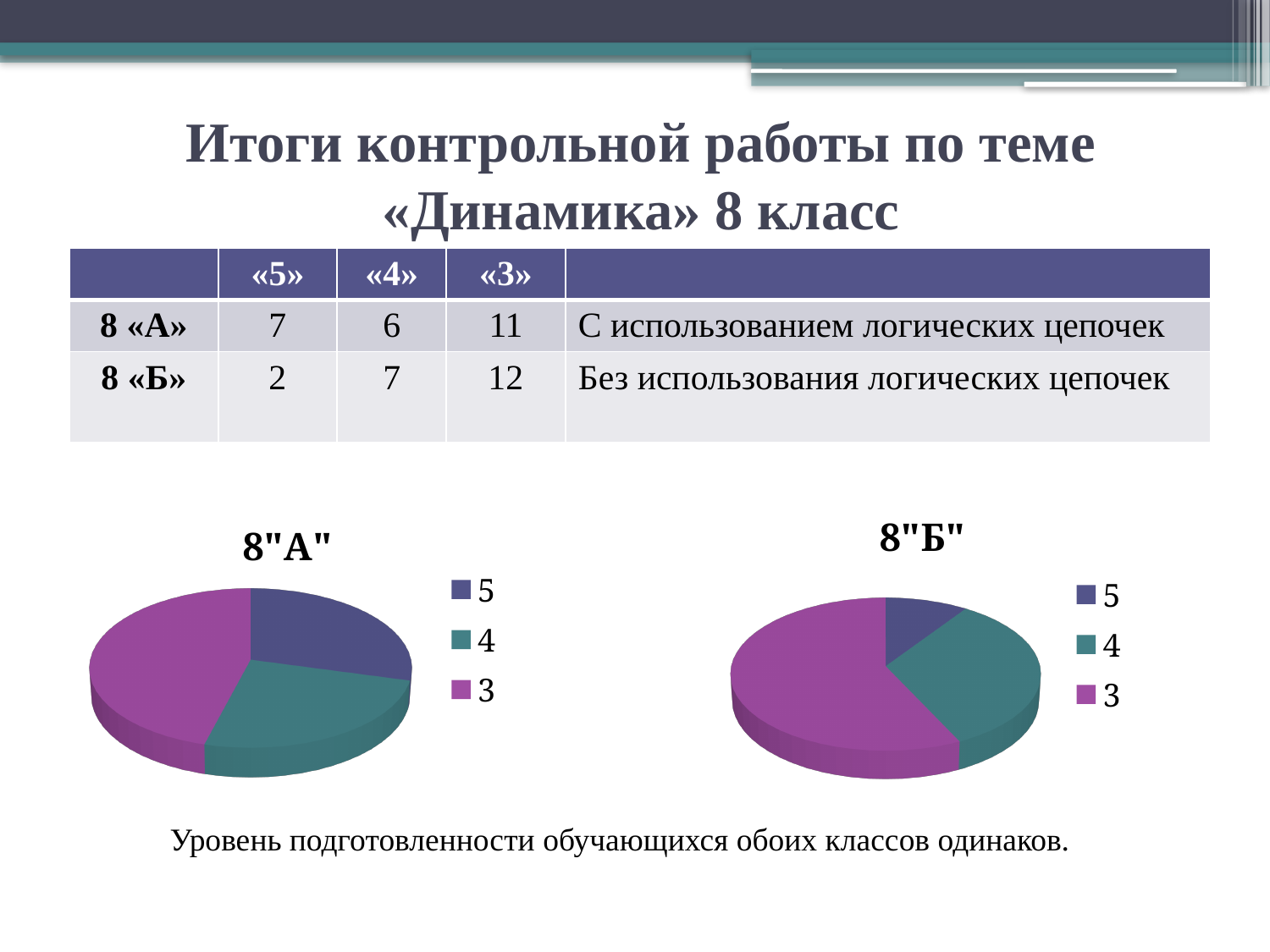
In the 8"Б" pie chart, which grade has the smallest slice? 5 According to the slide, how many students in 8 «А» received a «5»? 7 How many entries does the legend of the 8"Б" chart list? 3 What kind of chart is the 8"Б" chart? pie chart What kind of chart is the 8"A" chart? pie chart How many slices does the 8"A" pie chart have? 3 According to the slide, how many students in 8 «Б» received a «3»? 12 In the 8"Б" pie chart, which grade has the largest slice? 3 In the 8"Б" pie chart, which slice is larger: grade 4 or grade 5? 4 What colour represents grade 3 in the pie charts? purple In the 8"A" pie chart, which grade has the largest slice? 3 In the 8"A" pie chart, which slice is larger: grade 3 or grade 4? 3